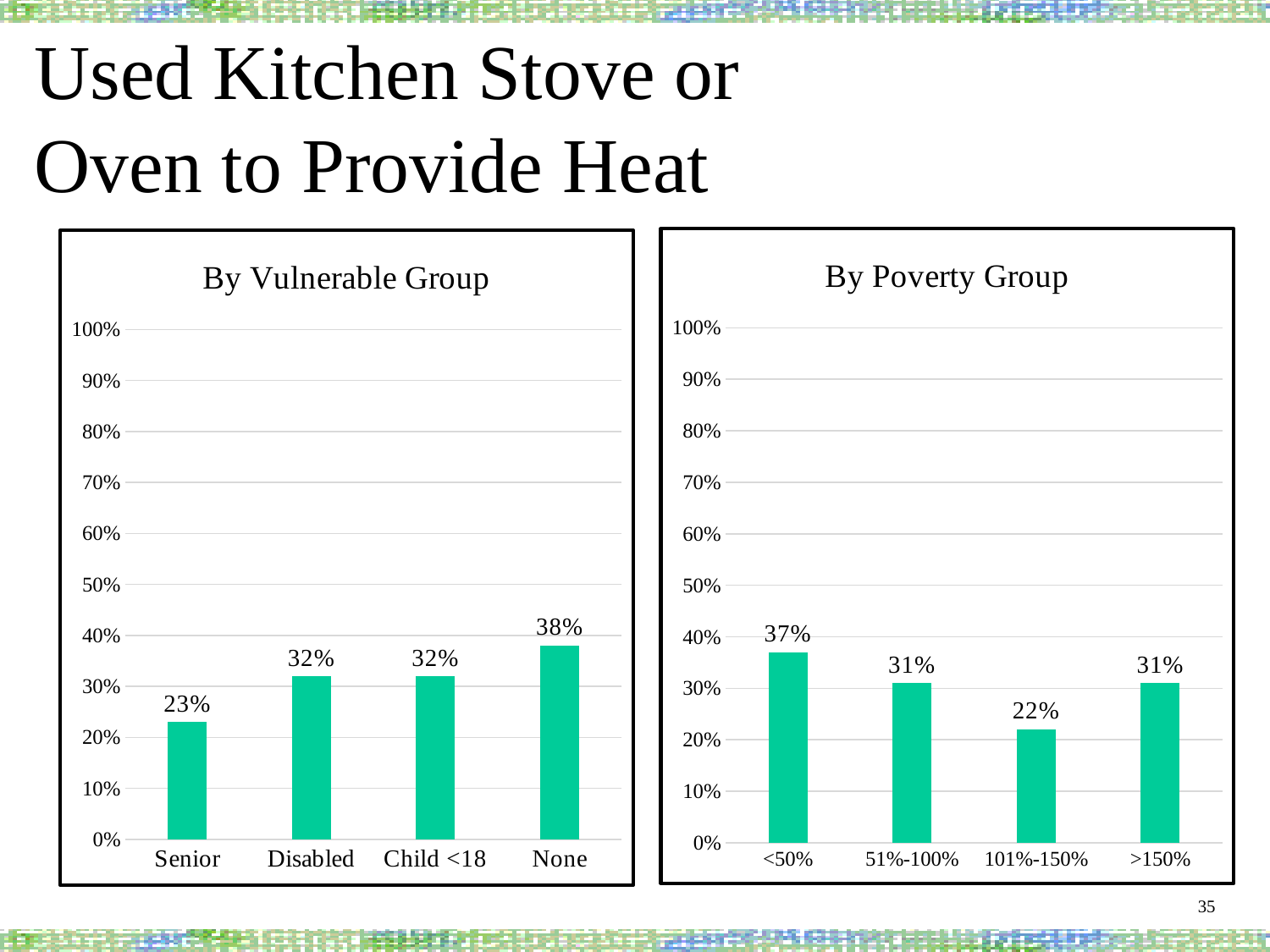
In the 'By Poverty Group' chart, what is the value for 101%-150%? 22% In the 'By Vulnerable Group' chart, what is the difference between the values for None and Senior? 15% In the 'By Poverty Group' chart, which is larger, the value for 51%-100% or the value for 101%-150%? 51%-100% What kind of chart is the 'By Poverty Group' chart? Bar chart In the 'By Vulnerable Group' chart, how many categories are shown? 4 In the 'By Poverty Group' chart, which category has the highest value? <50% What is the title of the chart on the left side of the slide? By Vulnerable Group In the 'By Poverty Group' chart, what is the difference between the values for <50% and 101%-150%? 15% In the 'By Vulnerable Group' chart, which category has the lowest value? Senior In the 'By Vulnerable Group' chart, which category has the highest value? None In the 'By Vulnerable Group' chart, what is the value for Senior? 23% In the 'By Poverty Group' chart, which category has the lowest value? 101%-150%